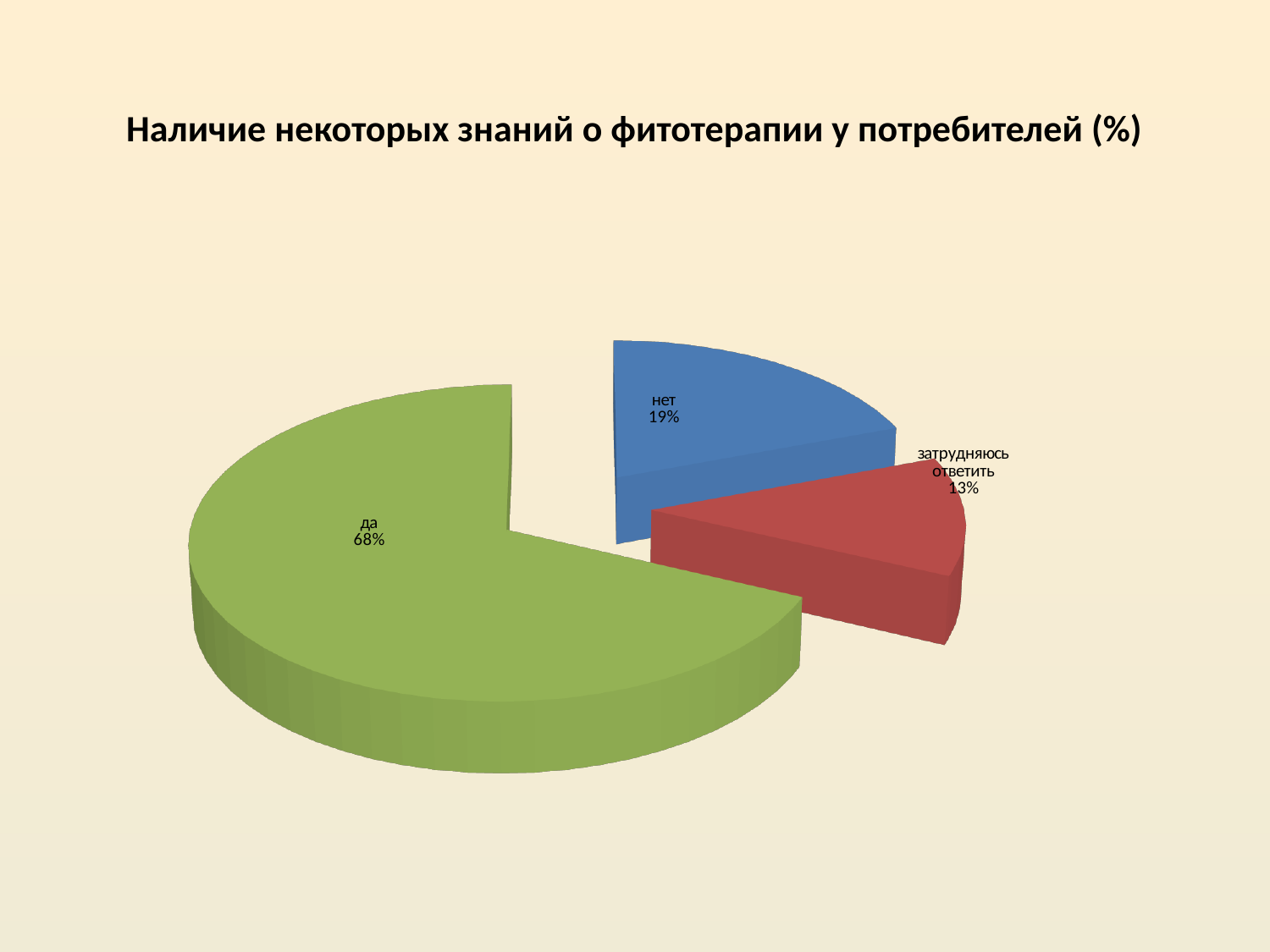
What is the title of the chart? Наличие некоторых знаний о фитотерапии у потребителей (%) How many slices does the pie chart have? 3 What is the difference in percentage points between the "нет" and "затрудняюсь ответить" slices? 6 What share of the pie does the "нет" slice represent? 19% Which category has the smallest share of the pie? затрудняюсь ответить What colour is the "да" slice? green What share of the pie does the "затрудняюсь ответить" slice represent? 13% What kind of chart is shown on the slide? pie chart What is the difference in percentage points between the "да" and "нет" slices? 49 What share of the pie does the "да" slice represent? 68% Which category has the largest share of the pie? да Which is larger, the "нет" slice or the "затрудняюсь ответить" slice? нет